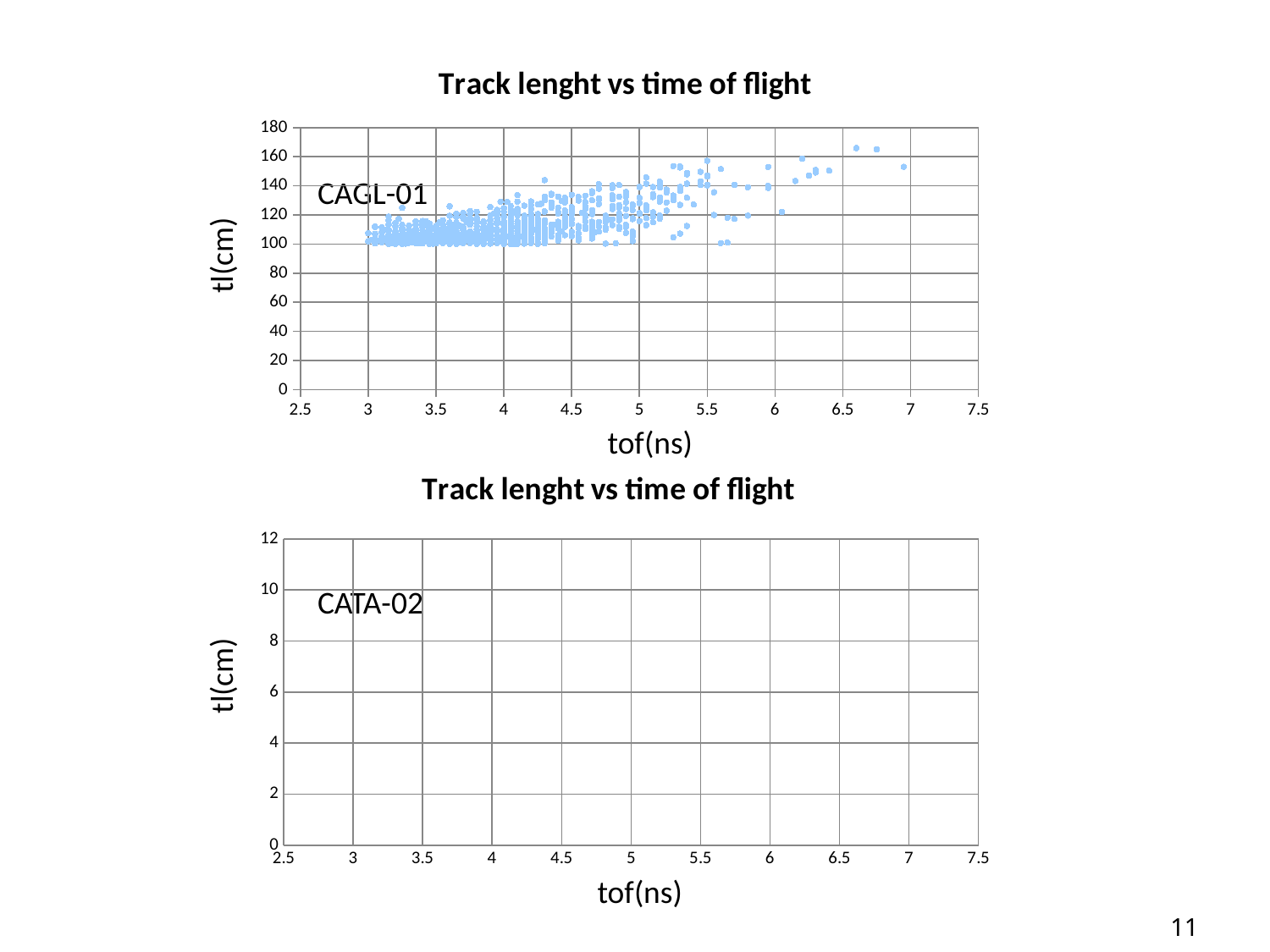
In the top chart, what label is written inside the plot area? CAGL-01 What kind of chart is the top chart on the slide? scatter chart In the top chart, what is the maximum value shown on the vertical axis? 180 What is the horizontal axis label of the bottom chart? tof(ns) In the top chart, do the track length values generally rise or fall as time of flight increases? rise How many data points are plotted in the bottom chart? 0 In the top chart, are the points at a time of flight of 3 ns greater or less than 120 cm? less In the top chart, are the highest points (near 6.5 ns) greater or less than 160 cm? greater In the top chart, is the track length of the point with the largest time of flight (near 7 ns) greater or less than 140? greater